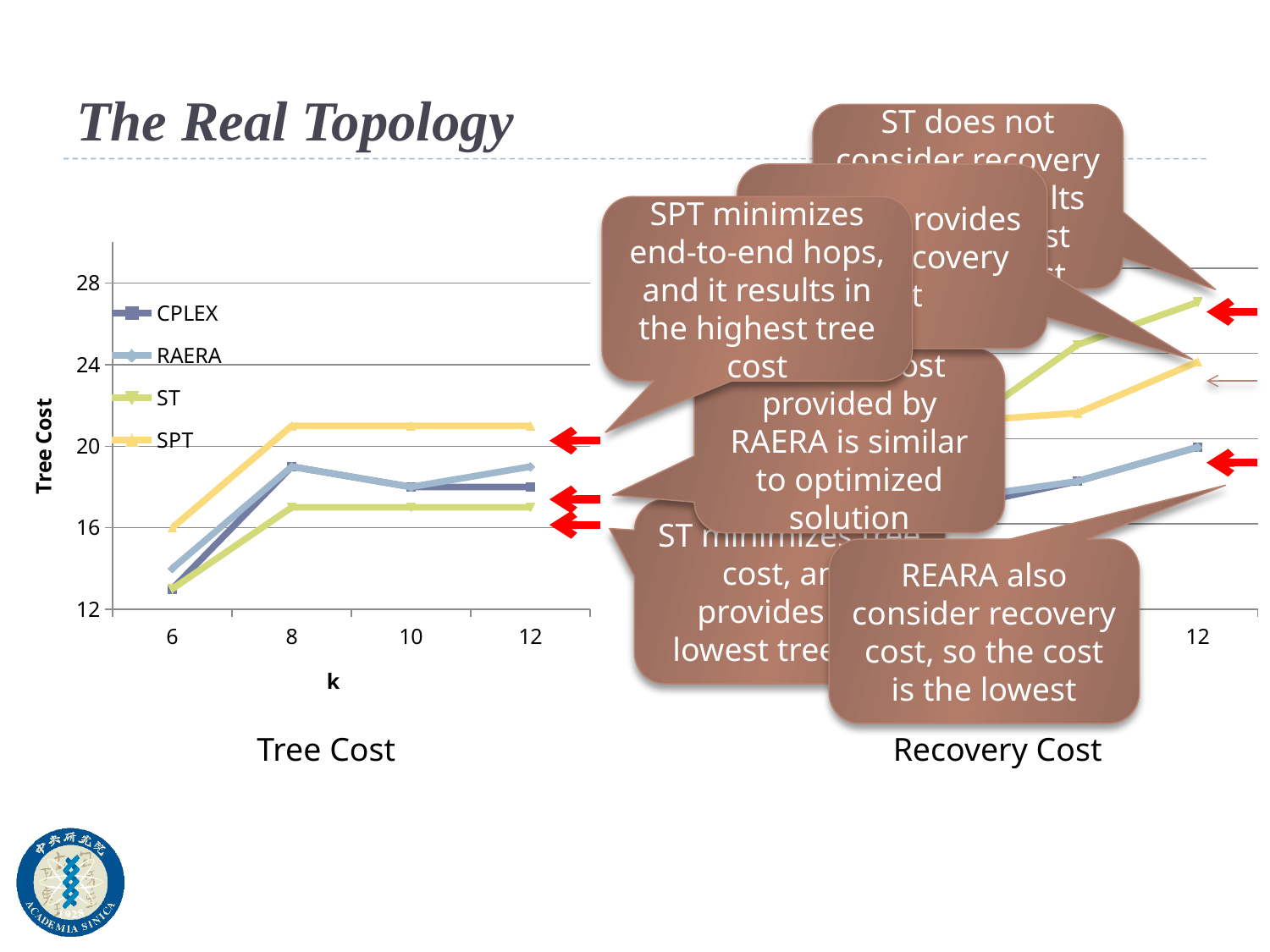
In the Tree Cost chart, how many series does the legend list? 4 What is the title of the chart on the right side of the slide? Recovery Cost In the Tree Cost chart, how many values of k are plotted on the x axis? 4 In the Tree Cost chart, which series has the lowest tree cost at k = 12? ST In the Tree Cost chart, which series has the highest tree cost at k = 12? SPT In the Tree Cost chart, what is the label of the x axis? k In the Tree Cost chart, is the value for CPLEX at k = 6 greater or less than 16? less In the Tree Cost chart, what kind of chart is shown? line chart In the Tree Cost chart, is the value for ST at k = 10 greater or less than 16? greater In the Tree Cost chart, does the SPT line rise or fall from k = 6 to k = 8? rise In the Tree Cost chart, is the value for SPT at k = 8 greater or less than 20? greater In the Tree Cost chart, which is larger at k = 10, the value for SPT or the value for ST? SPT